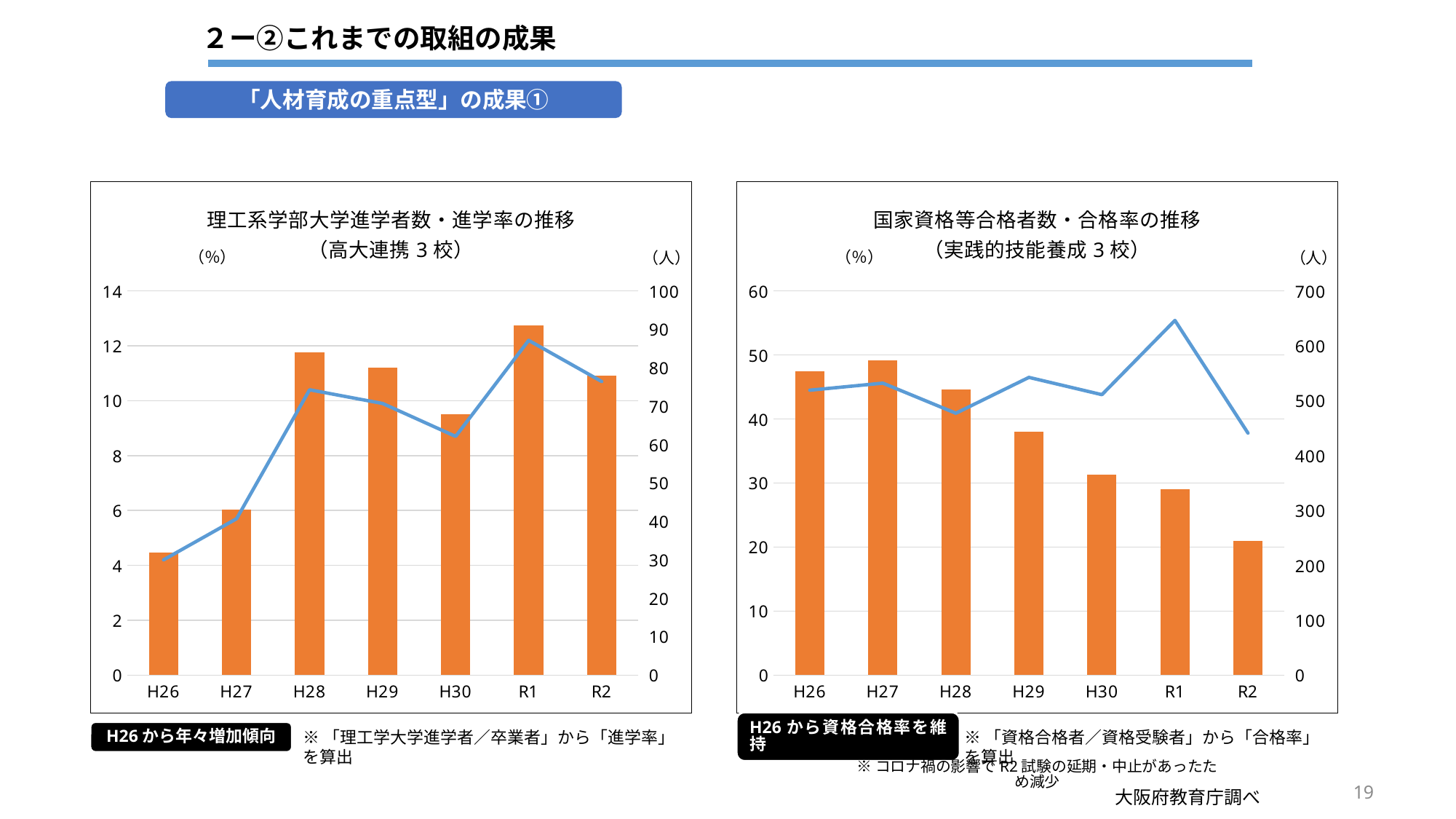
In the right chart (国家資格等合格者数・合格率の推移), which year has the shortest bar? R2 In the left chart (理工系学部大学進学者数・進学率の推移), which year has the tallest bar? R1 In the left chart (理工系学部大学進学者数・進学率の推移), how many year categories are shown on the x axis? 7 In the left chart (理工系学部大学進学者数・進学率の推移), is the bar for H28 greater or less than 80 on the right-hand (人) axis? greater In the right chart (国家資格等合格者数・合格率の推移), is the bar for R2 greater or less than 300 on the right-hand (人) axis? less In the right chart (国家資格等合格者数・合格率の推移), in which year does the line reach its highest point? R1 In the right chart (国家資格等合格者数・合格率の推移), do the bar heights generally rise or fall from H27 to R2? fall In the left chart (理工系学部大学進学者数・進学率の推移), is the bar for H27 greater or less than 50 on the right-hand (人) axis? less In the right chart (国家資格等合格者数・合格率の推移), which year has the tallest bar? H27 In the left chart (理工系学部大学進学者数・進学率の推移), which bar is taller, H29 or H30? H29 In the left chart (理工系学部大学進学者数・進学率の推移), which year has the shortest bar? H26